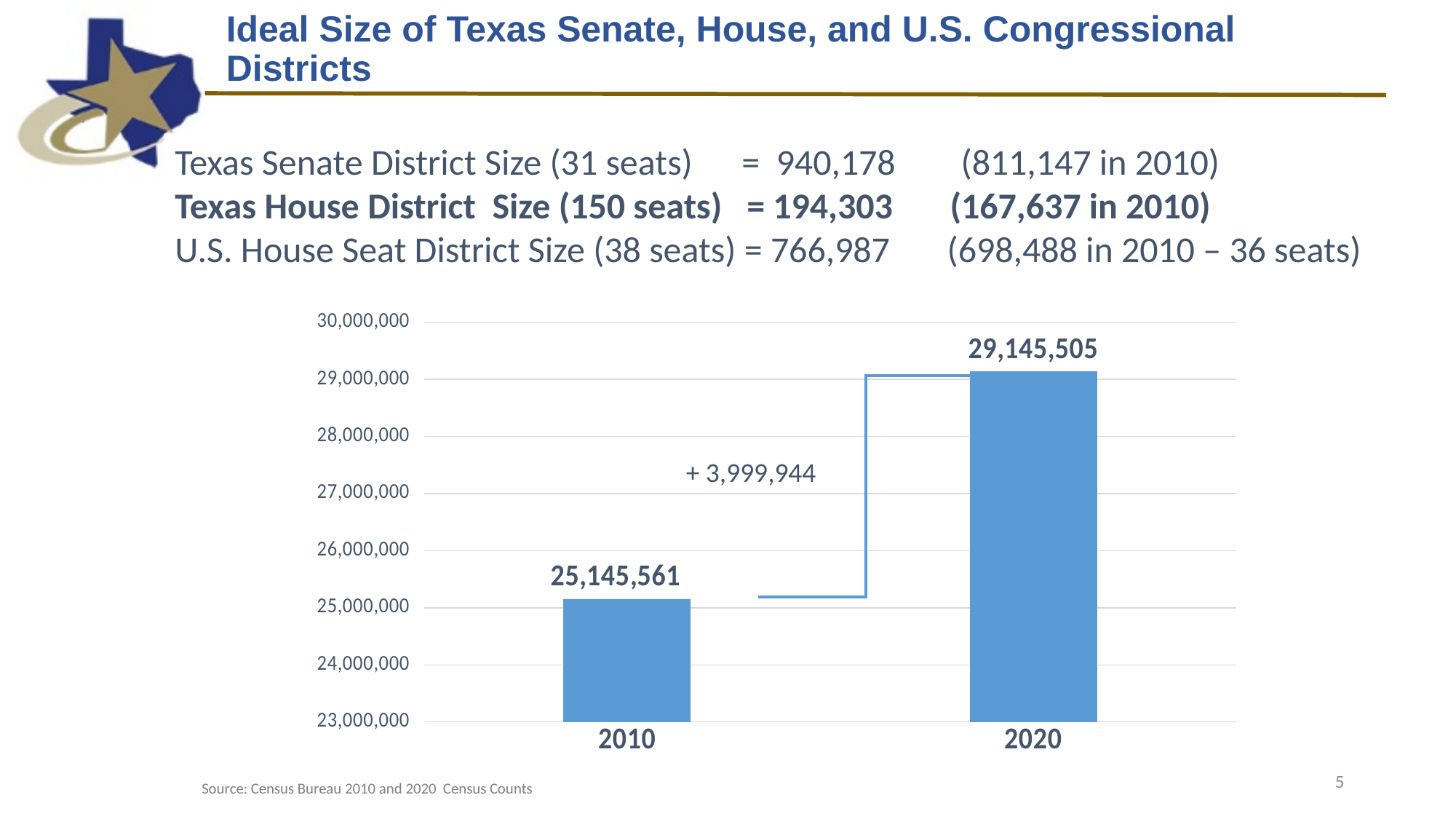
Is the value for 2020 larger or smaller than the value for 2010? larger What is the lowest value labelled on the vertical axis of the chart? 23,000,000 Do the values rise or fall from 2010 to 2020? rise What is the value shown for 2020 in the bar chart? 29,145,505 How many bars are plotted in the chart? 2 Which year has the higher value in the bar chart? 2020 Which year has the lower value in the bar chart? 2010 Is the value for 2020 greater or less than 29,000,000? greater What kind of chart is shown on the slide? bar chart What is the difference between the 2020 and 2010 values in the bar chart? 3,999,944 What is the value shown for 2010 in the bar chart? 25,145,561 Is the value for 2010 greater or less than 26,000,000? less